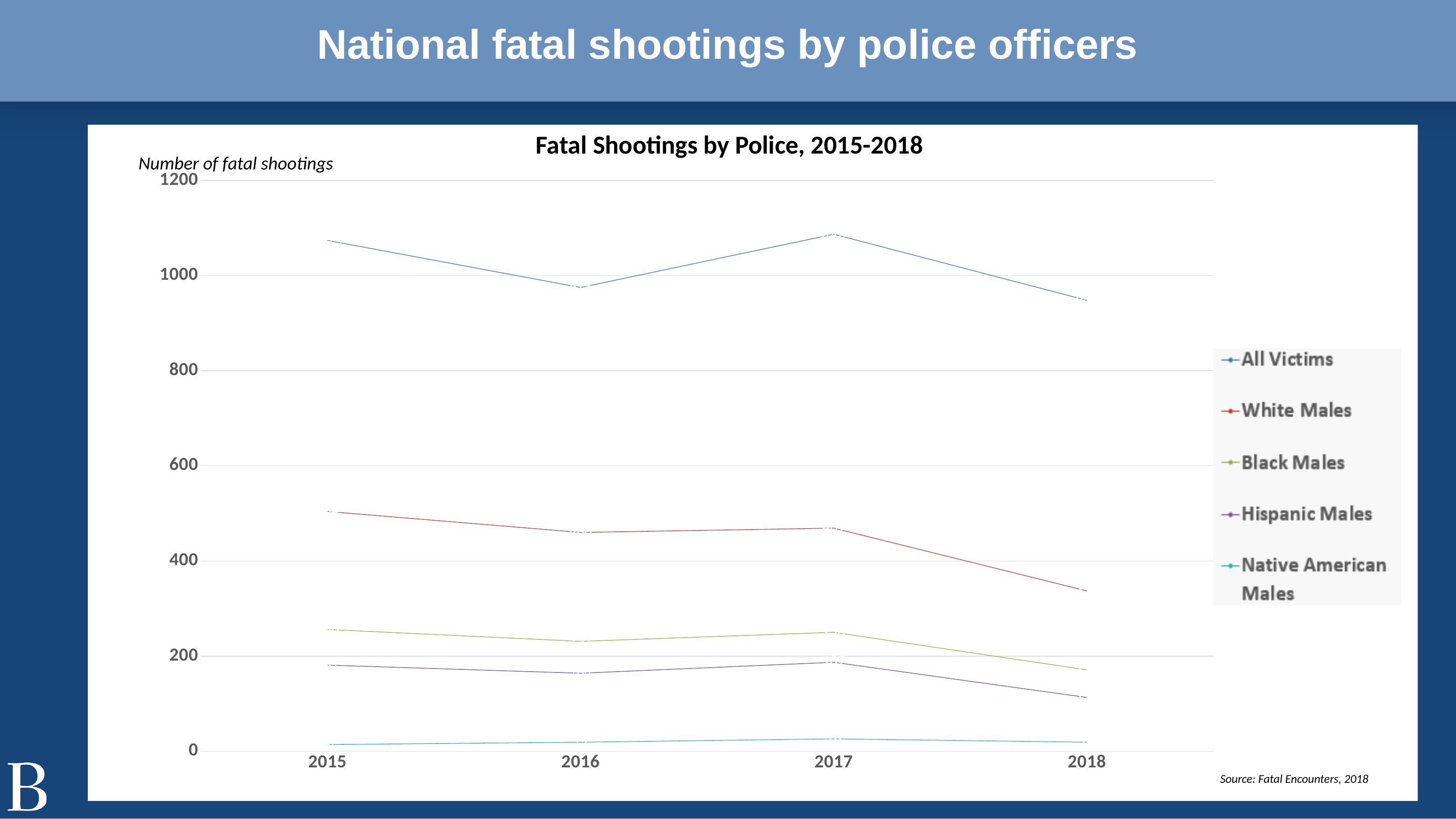
Is the value for White Males in 2015 greater or less than 400? greater In which year is the value for White Males lowest? 2018 How many years are plotted along the x axis? 4 In which year is the value for Hispanic Males lowest? 2018 Does the value for White Males rise or fall from 2017 to 2018? Fall How many series does the legend list? 5 Is the value for Black Males in 2018 greater or less than 200? less What is the title of the chart? Fatal Shootings by Police, 2015-2018 Is the value for All Victims in 2016 greater or less than 1000? less In 2015, which is larger: the value for White Males or the value for Black Males? White Males What kind of chart is shown on the slide? Line chart